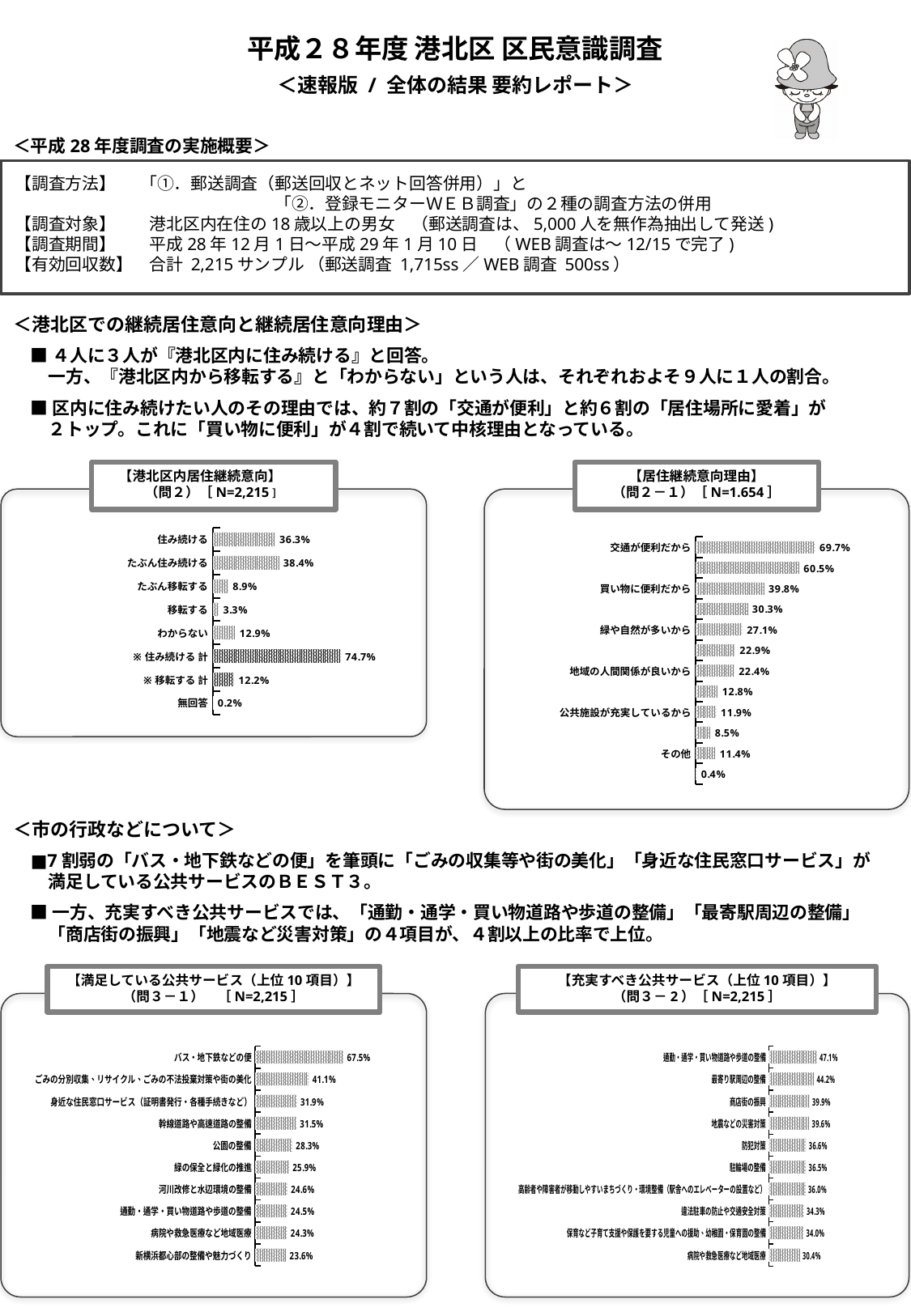
In the 【満足している公共サービス（上位10項目）】 chart, which category has the lowest value? 新横浜都心部の整備や魅力づくり In the 【港北区内居住継続意向】 chart, what is the value for ※ 住み続ける 計? 74.7% In the 【港北区内居住継続意向】 chart, what is the difference between たぶん住み続ける and 住み続ける? 2.1% In the 【充実すべき公共サービス（上位10項目）】 chart, what is the value for 最寄り駅周辺の整備? 44.2% In the 【居住継続意向理由】 chart, what is the value for 交通が便利だから? 69.7% In the 【居住継続意向理由】 chart, which is larger, 買い物に便利だから or 緑や自然が多いから? 買い物に便利だから In the 【充実すべき公共サービス（上位10項目）】 chart, what is the difference between 通勤・通学・買い物道路や歩道の整備 and 病院や救急医療など地域医療? 16.7% What kind of chart is the 【居住継続意向理由】 chart? bar chart In the 【満足している公共サービス（上位10項目）】 chart, which category has the highest value? バス・地下鉄などの便 In the 【港北区内居住継続意向】 chart, what is the value for 住み続ける? 36.3% In the 【満足している公共サービス（上位10項目）】 chart, what is the value for 公園の整備? 28.3% In the 【港北区内居住継続意向】 chart, how many categories are plotted? 8